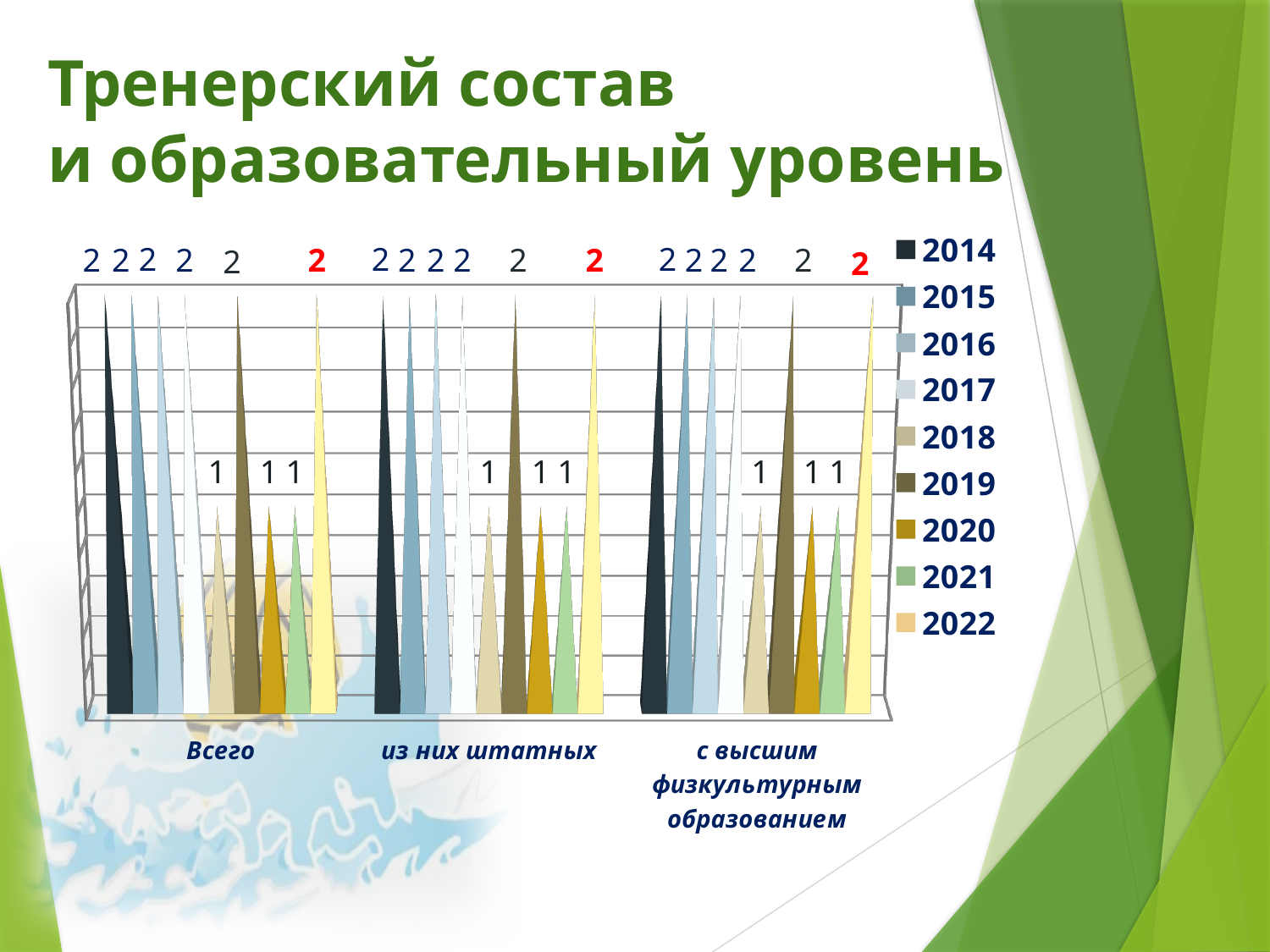
What is the value for 2014 in the "Всего" category? 2 What is the difference between the 2019 and 2018 values in the "Всего" category? 1 How many categories are shown on the x axis of the chart? 3 What is the title of the slide? Тренерский состав и образовательный уровень Which year is listed first in the chart legend? 2014 What is the value for 2019 in the "с высшим физкультурным образованием" category? 2 What kind of chart is shown on the slide? bar chart What is the value for 2018 in the "из них штатных" category? 1 What is the value for 2020 in the "Всего" category? 1 How many series does the legend list? 9 What is the value for 2022 in the "с высшим физкультурным образованием" category? 2 In the "из них штатных" category, which is larger: the value for 2019 or the value for 2021? 2019